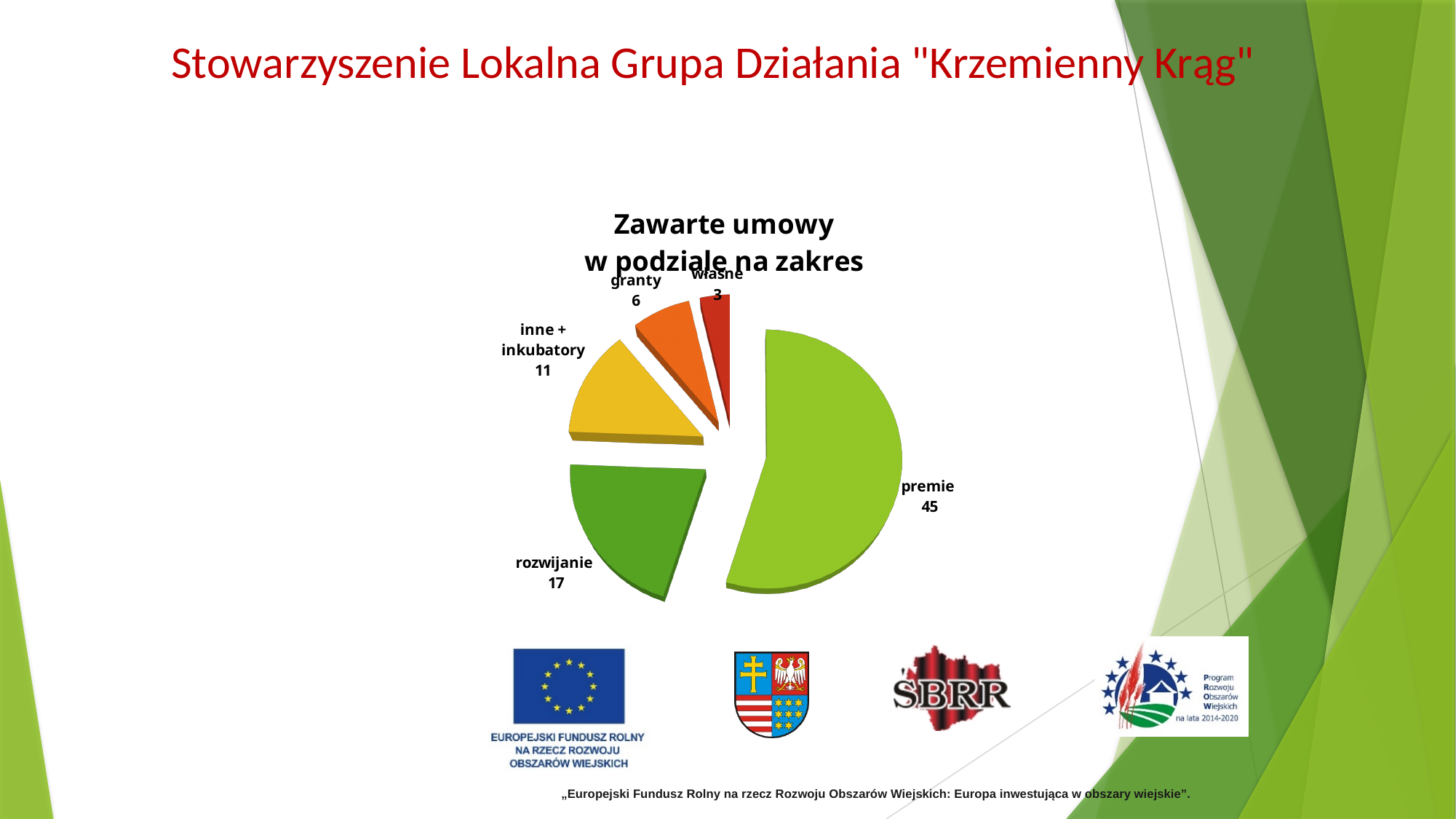
What is the value for premie? 45 Which category has the smallest slice? własne What is the value for rozwijanie? 17 What is the title of the chart? Zawarte umowy w podziale na zakres Which is larger, the value for inne + inkubatory or the value for granty? inne + inkubatory What is the value for inne + inkubatory? 11 What is the value for własne? 3 Which category has the largest slice? premie What kind of chart is shown on the slide? pie chart What is the value for granty? 6 What is the difference between the values for premie and rozwijanie? 28 How many slices does the pie chart have? 5